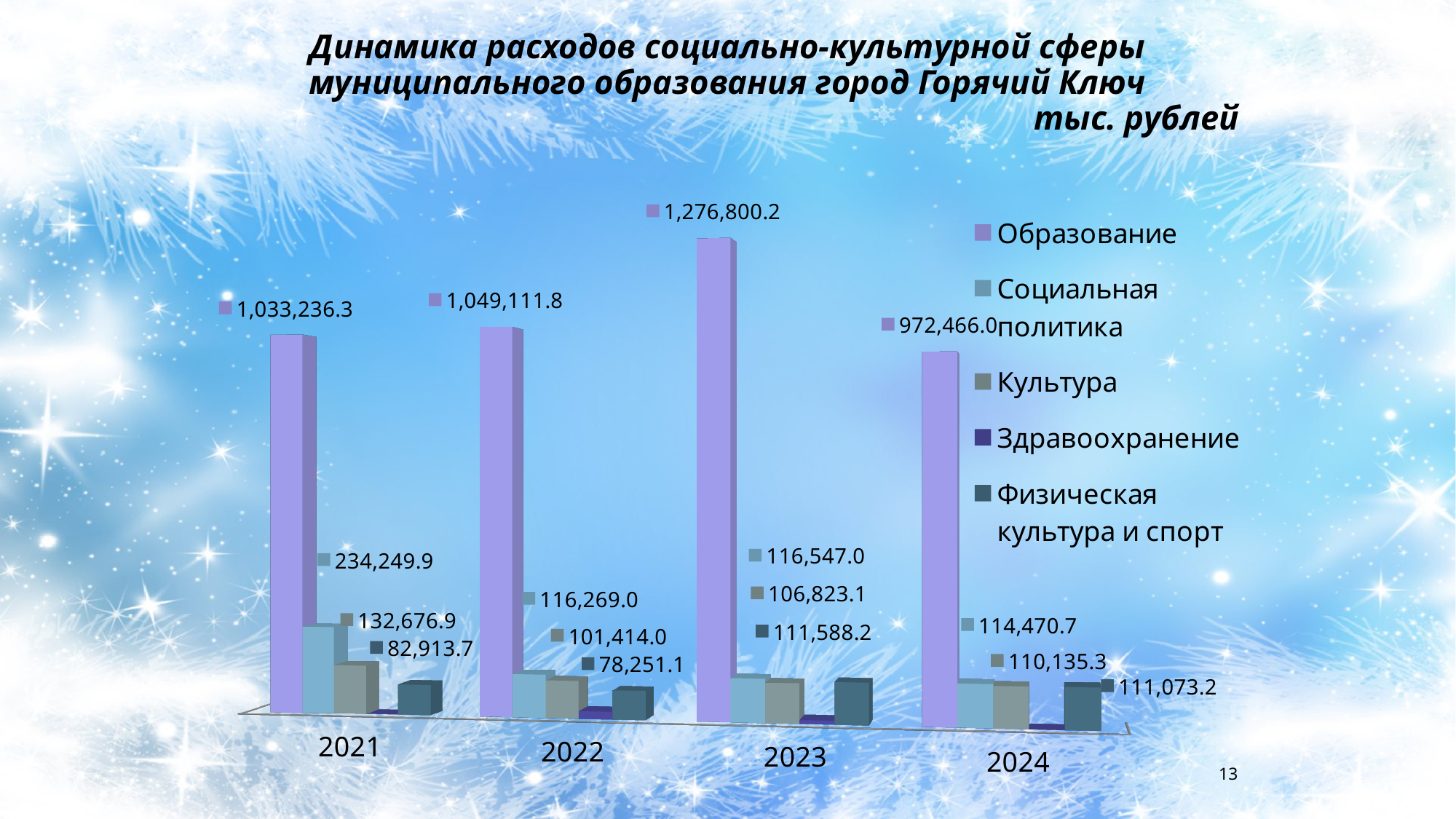
What is the value for Культура in 2022? 101,414.0 How many years are shown on the x axis? 4 What kind of chart is shown on the slide? Bar chart What is the value for Физическая культура и спорт in 2024? 111,073.2 How many series does the legend list? 5 What is the value for Социальная политика in 2021? 234,249.9 In which year is the value for Образование the highest? 2023 Which is larger in 2023: Культура or Физическая культура и спорт? Физическая культура и спорт What is the value for Образование in 2023? 1,276,800.2 What is the difference between the Социальная политика values for 2021 and 2022? 117,980.9 In which year is the value for Образование the lowest? 2024 What is the difference between the Образование values for 2023 and 2024? 304,334.2